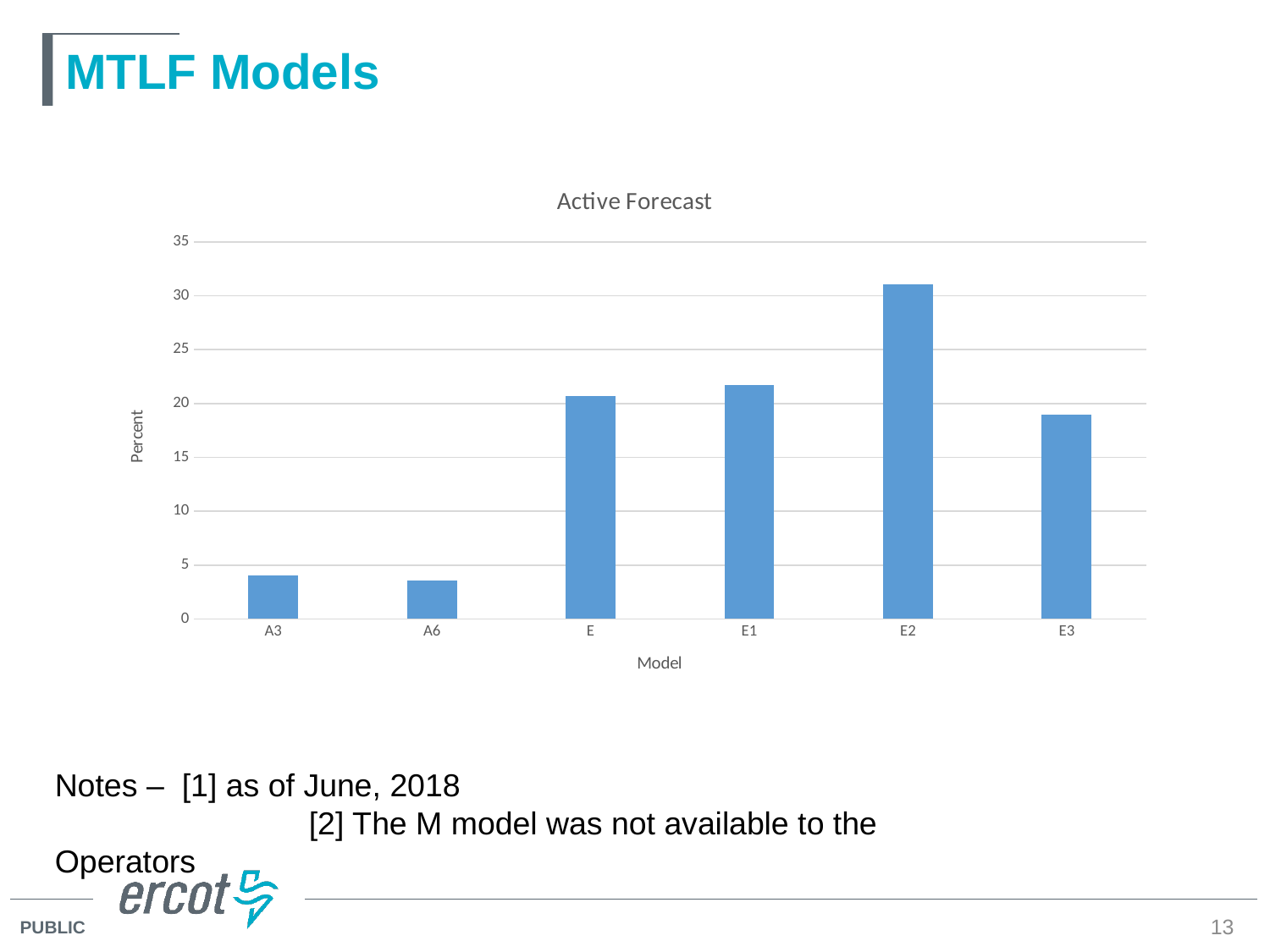
Is the value for A3 greater or less than 5? less Is the value for E3 greater or less than 20? less What is the title of the chart? Active Forecast What is the label on the y axis of the chart? Percent Is the value for E2 greater or less than 30? greater Which has the larger value, A3 or E? E What kind of chart is shown on the slide? bar chart Which has the larger value, E2 or E3? E2 Which model has the highest value in the Active Forecast chart? E2 How many models are shown on the x axis of the chart? 6